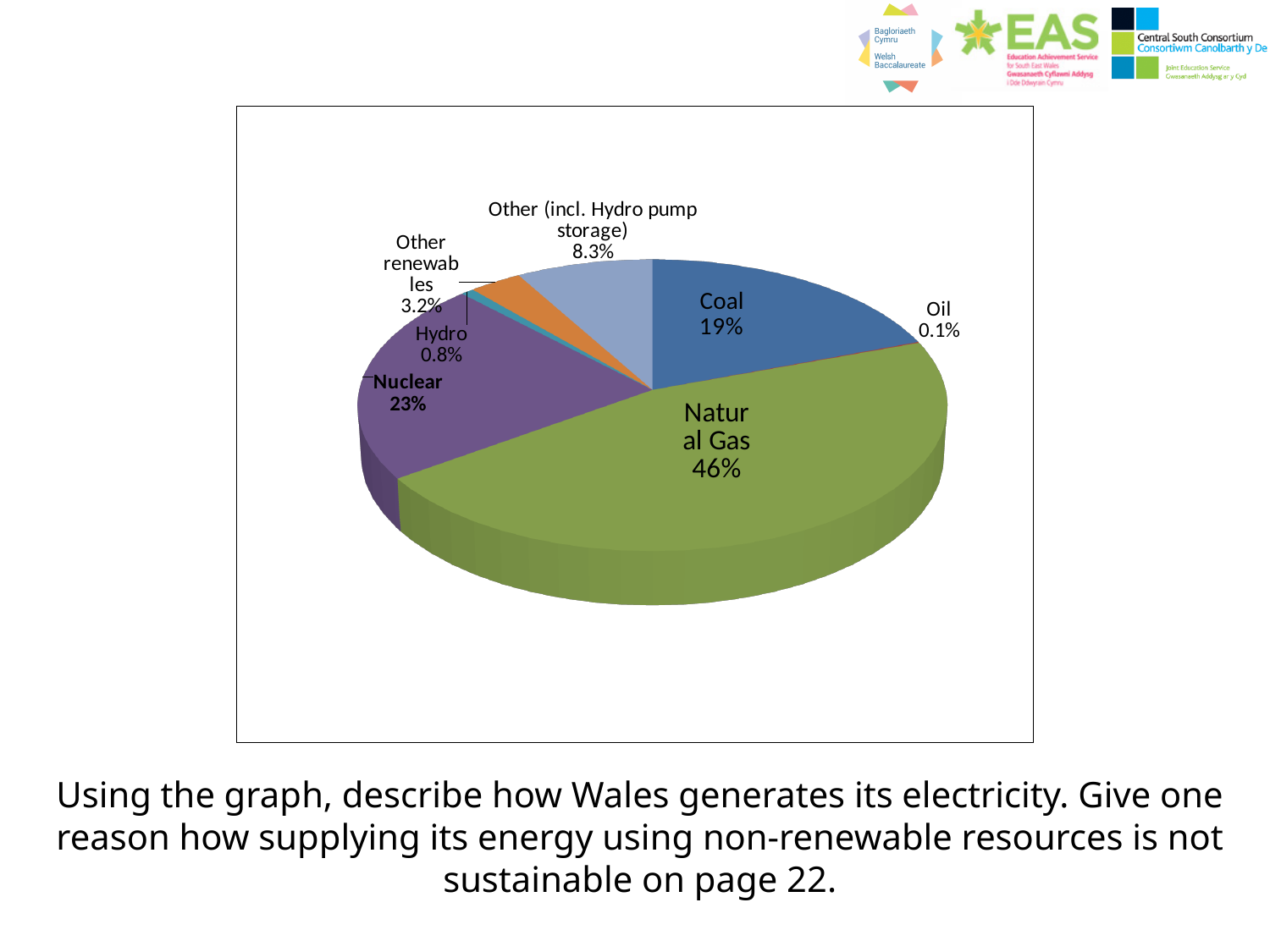
Which slice of the pie is the smallest? Oil What percentage of the pie is Nuclear? 23% How many slices does the pie chart have? 7 What percentage of the pie is Oil? 0.1% What is the difference in percentage points between Natural Gas and Nuclear? 23 What type of chart is shown on the slide? Pie chart What percentage of the pie is Other (incl. Hydro pump storage)? 8.3% What percentage of the pie is Coal? 19% Which slice of the pie is the largest? Natural Gas What percentage of the pie is Natural Gas? 46% What percentage of the pie is Hydro? 0.8% Which is larger, the Coal slice or the Nuclear slice? Nuclear